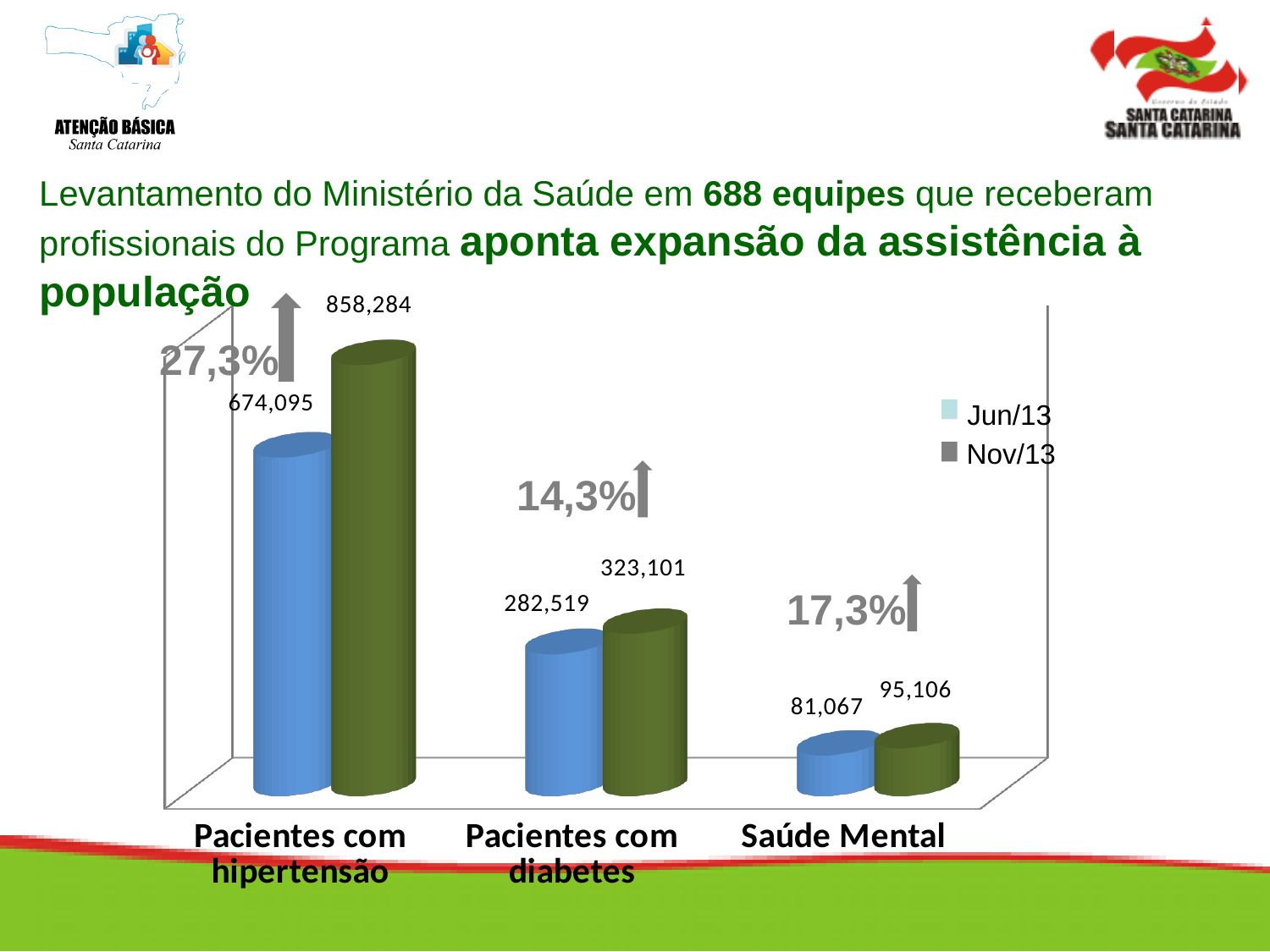
What is the Jun/13 value for Pacientes com hipertensão? 674,095 Which is larger for Pacientes com hipertensão, the Jun/13 value or the Nov/13 value? Nov/13 What is the Nov/13 value for Saúde Mental? 95,106 What is the Nov/13 value for Pacientes com hipertensão? 858,284 What is the difference between the Nov/13 and Jun/13 values for Saúde Mental? 14,039 What percentage increase is shown above the Pacientes com diabetes bars? 14,3% What is the difference between the Nov/13 and Jun/13 values for Pacientes com diabetes? 40,582 How many series does the chart legend list? 2 Which category has the lowest Jun/13 value? Saúde Mental Which category has the highest Nov/13 value? Pacientes com hipertensão What is the Jun/13 value for Pacientes com diabetes? 282,519 How many categories are shown on the x axis of the chart? 3